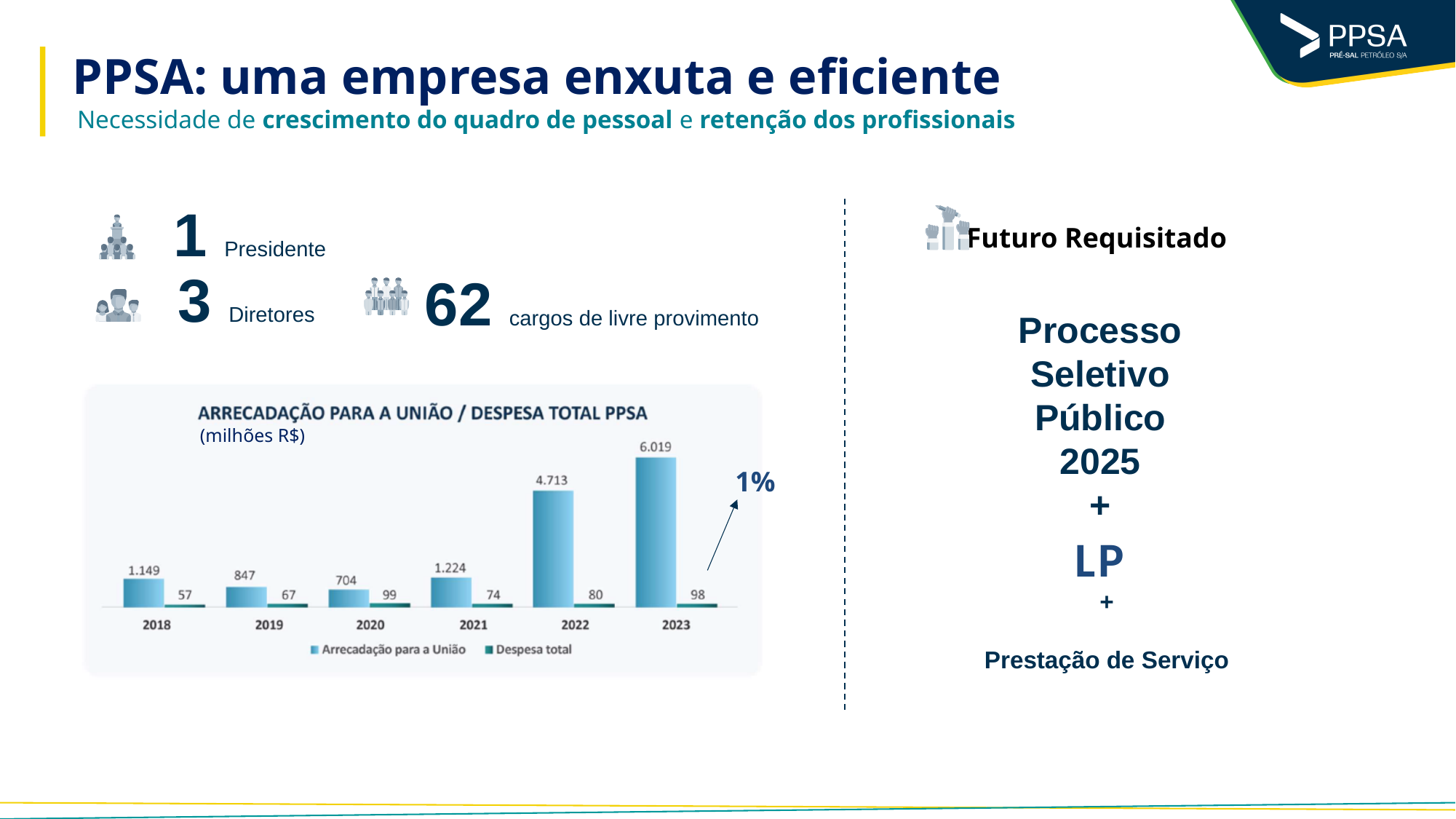
Which year has the lowest Arrecadação para a União? 2020 What is the difference between the Despesa total in 2020 and in 2018? 42 What is the Despesa total value for 2020? 99 Which is larger, the Arrecadação para a União in 2018 or in 2021? 2021 What is the difference between the Despesa total in 2023 and in 2022? 18 Which year has the highest Arrecadação para a União? 2023 How many series does the chart legend list? 2 Which year has the lowest Despesa total? 2018 How many years are shown on the x axis of the chart? 6 What is the value of Arrecadação para a União in 2023? 6.019 What is the Arrecadação para a União value for 2019? 847 What type of chart is shown on the slide? Bar chart